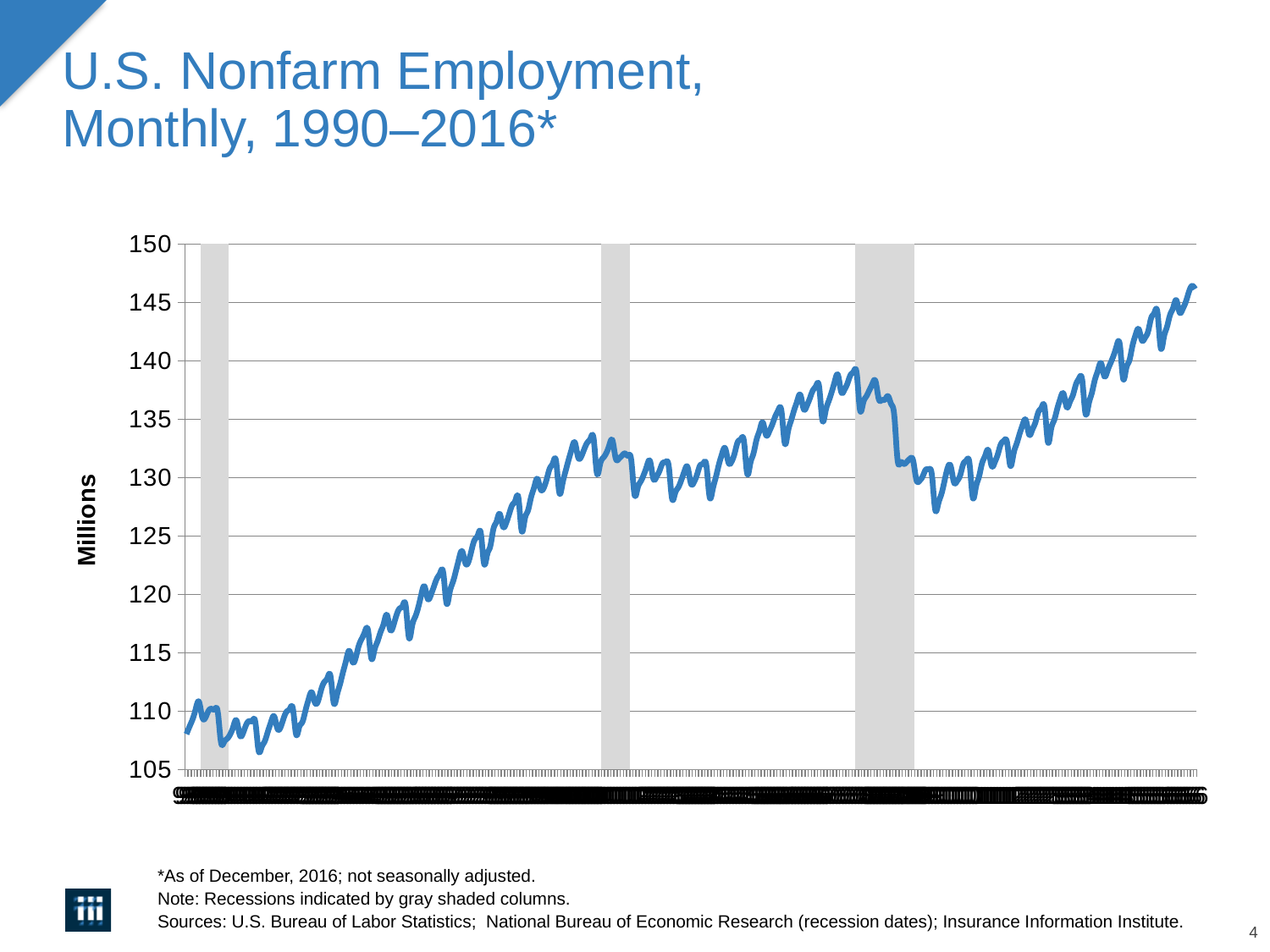
Which is larger: the employment value at the start of the series (1990) or at the end of the series (2016)? End of the series (2016) Within the rightmost gray shaded recession column, does the employment line rise or fall? Fall Is the value at the end of the series (December 2016) greater or less than 140? greater Is the value at the start of the series (1990) greater or less than 110? less What kind of chart is shown on the slide? Line chart How many gray shaded recession columns appear on the chart? 3 Overall, does U.S. nonfarm employment rise or fall from 1990 to 2016 along the x axis? Rise Is the highest value reached by the line greater or less than 150? less What is the label on the vertical axis of the chart? Millions